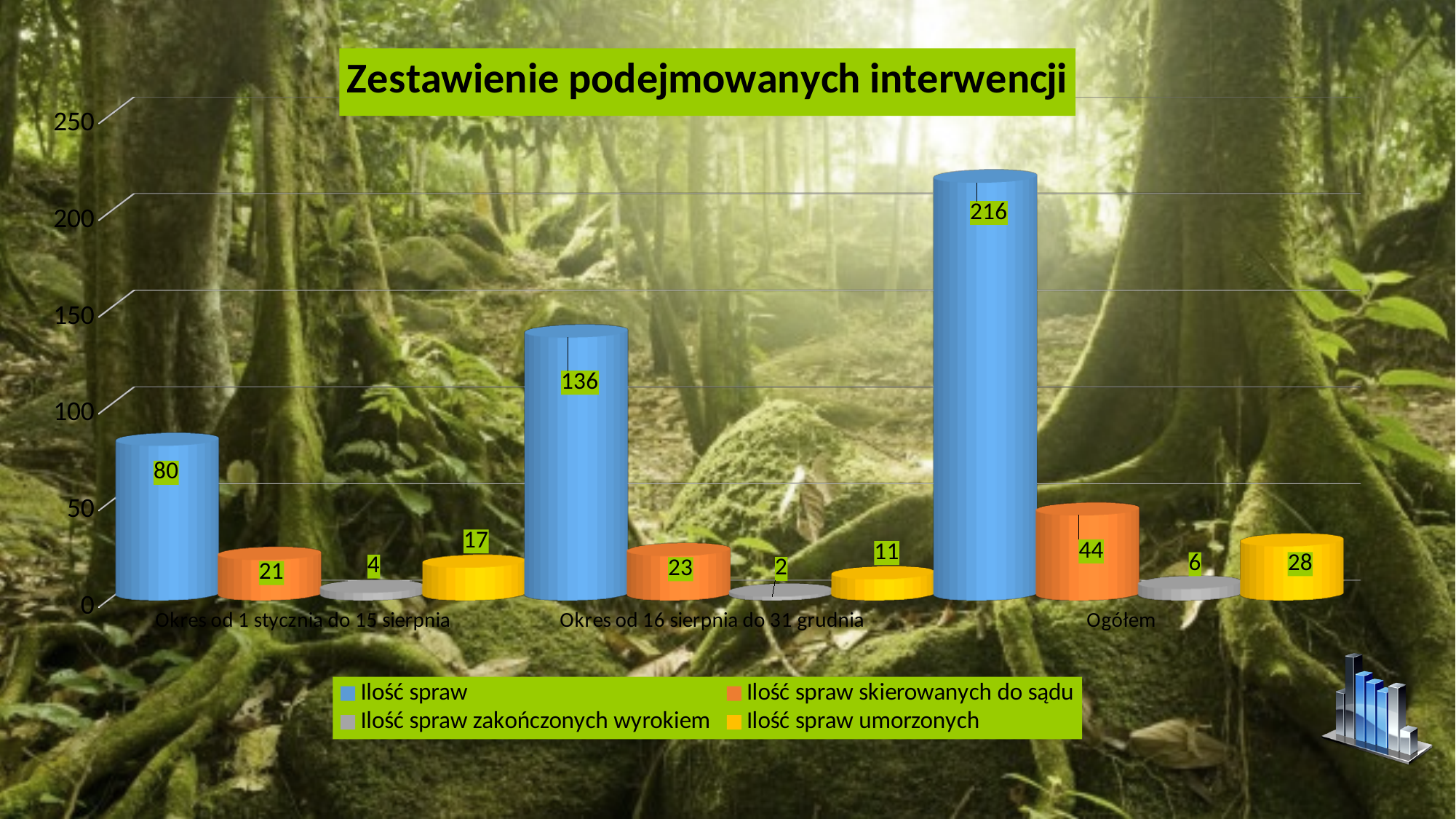
Is the value of 'Ilość spraw' for 'Ogółem' greater or less than 200? greater What is the value of 'Ilość spraw' for 'Okres od 1 stycznia do 15 sierpnia'? 80 Which category has the lowest value for 'Ilość spraw zakończonych wyrokiem'? Okres od 16 sierpnia do 31 grudnia What is the title of the chart? Zestawienie podejmowanych interwencji Which category has the highest value for 'Ilość spraw'? Ogółem Which is larger: 'Ilość spraw umorzonych' for 'Okres od 1 stycznia do 15 sierpnia' or for 'Okres od 16 sierpnia do 31 grudnia'? Okres od 1 stycznia do 15 sierpnia How many series does the legend list? 4 How many categories are shown on the x axis? 3 What is the value of 'Ilość spraw umorzonych' for 'Ogółem'? 28 What is the difference between 'Ilość spraw' for 'Okres od 16 sierpnia do 31 grudnia' and for 'Okres od 1 stycznia do 15 sierpnia'? 56 What is the value of 'Ilość spraw zakończonych wyrokiem' for 'Okres od 1 stycznia do 15 sierpnia'? 4 What is the value of 'Ilość spraw skierowanych do sądu' for 'Okres od 16 sierpnia do 31 grudnia'? 23